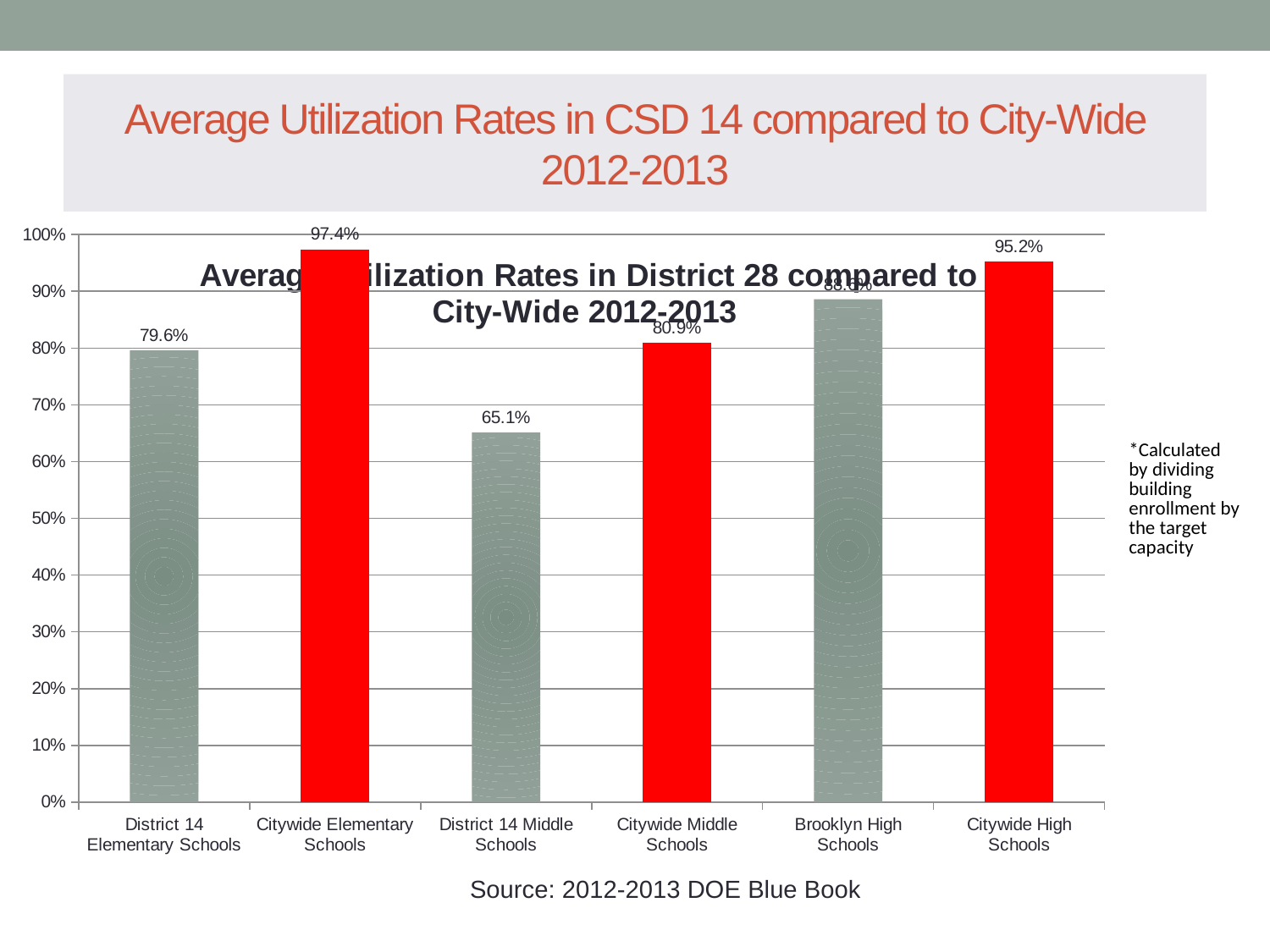
Is the utilization rate for Brooklyn High Schools greater or less than 80%? greater What is the average utilization rate for District 14 Elementary Schools? 79.6% What kind of chart is shown on the slide? bar chart What is the average utilization rate for Citywide Elementary Schools? 97.4% Which has a higher utilization rate, District 14 Middle Schools or Citywide Middle Schools? Citywide Middle Schools Which category has the lowest utilization rate? District 14 Middle Schools Which category has the highest utilization rate? Citywide Elementary Schools How many categories are shown on the x axis of the chart? 6 What is the average utilization rate for Citywide Middle Schools? 80.9% What is the average utilization rate for District 14 Middle Schools? 65.1% What is the average utilization rate for Citywide High Schools? 95.2% How much higher is the utilization rate for Citywide Elementary Schools than for District 14 Elementary Schools? 17.8%